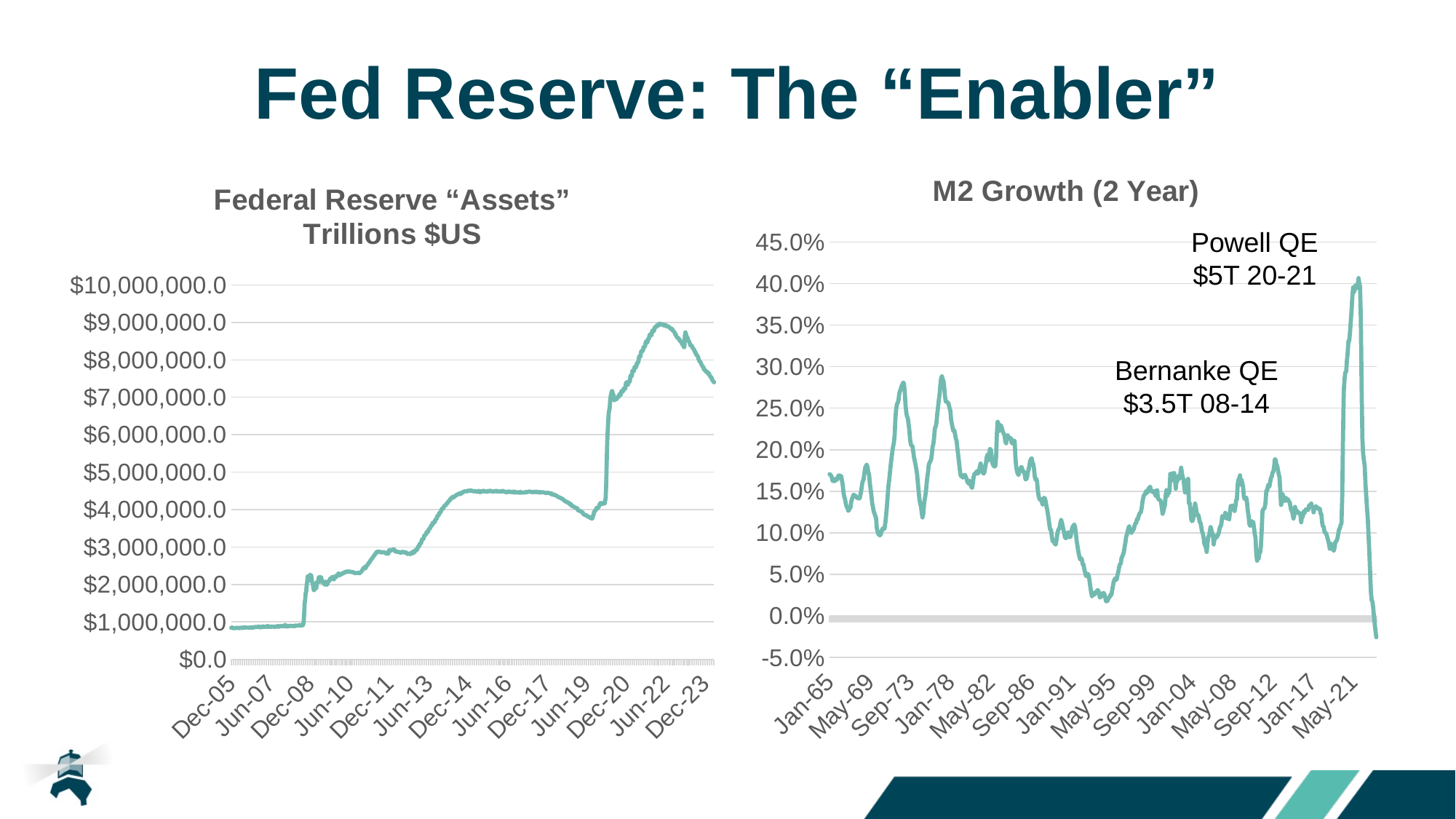
On the Federal Reserve “Assets” chart, do the values overall rise or fall from Dec-05 to Dec-23? rise On the M2 Growth (2 Year) chart, what dollar amount does the annotation give for Bernanke QE? $3.5T On the Federal Reserve “Assets” chart, which is larger, the value at Jun-22 or the value at Dec-23? Jun-22 What kind of chart is the "Federal Reserve “Assets” Trillions $US" chart on the left? line chart On the Federal Reserve “Assets” chart, is the value at Dec-20 greater or less than $6,000,000.0? greater On the Federal Reserve “Assets” chart, is the value at Dec-14 greater or less than $4,000,000.0? greater On the M2 Growth (2 Year) chart, is the value at Jan-65 greater or less than 10.0%? greater What kind of chart is the "M2 Growth (2 Year)" chart on the right? line chart